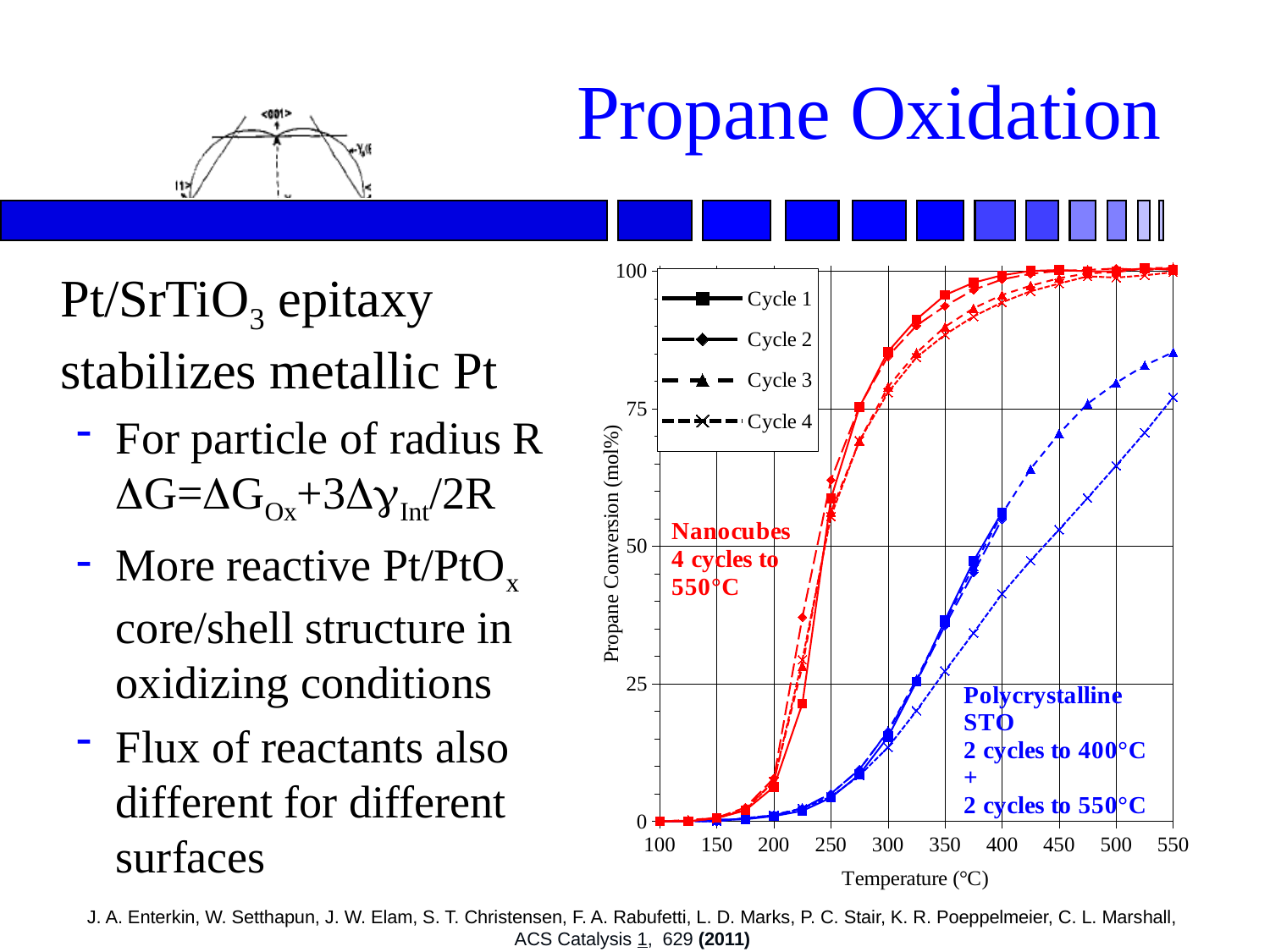
Do the propane conversion values rise or fall as temperature increases along the x axis? rise Is the propane conversion for the red Nanocubes Cycle 1 curve at 300°C greater or less than 75? greater What kind of chart is shown on the slide? line chart At 400°C, which has the higher propane conversion: the red Nanocubes curves or the blue Polycrystalline STO curves? Nanocubes Is the propane conversion for the blue Polycrystalline STO Cycle 1 curve at 400°C greater or less than 50? greater How many series does the chart's legend list? 4 Is the propane conversion for the blue Polycrystalline STO curves at 300°C greater or less than 25? less At 550°C, which blue Polycrystalline STO curve has the higher propane conversion: Cycle 3 or Cycle 4? Cycle 3 What is the label of the y axis of the chart? Propane Conversion (mol%) What is the label of the x axis of the chart? Temperature (°C)